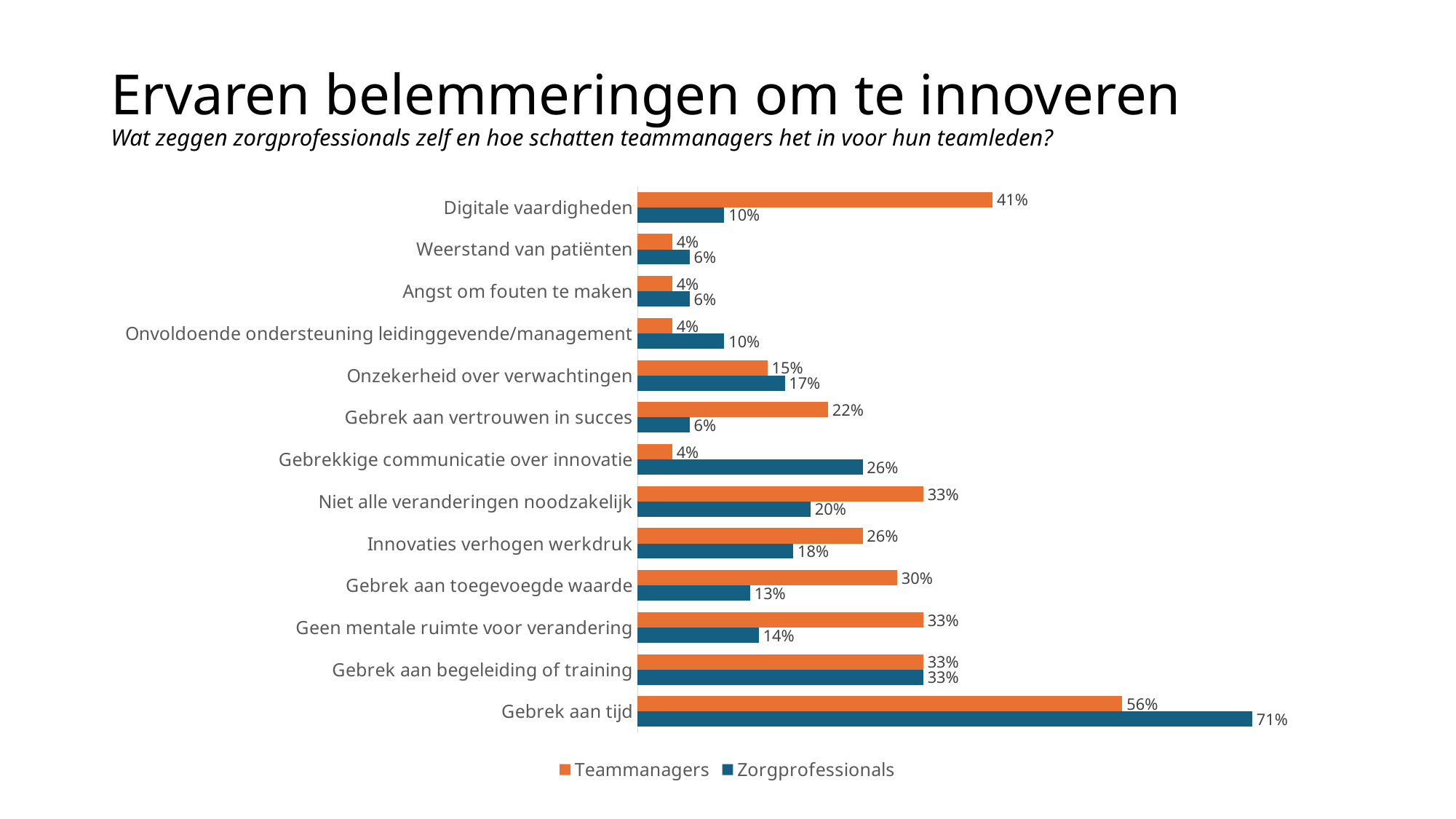
What is the Zorgprofessionals value for Gebrek aan tijd? 71% What is the difference between the Zorgprofessionals and Teammanagers values for Gebrek aan tijd? 15 percentage points What is the difference between the Teammanagers and Zorgprofessionals values for Digitale vaardigheden? 31 percentage points Which category has the highest Zorgprofessionals value? Gebrek aan tijd What is the Teammanagers value for Digitale vaardigheden? 41% How many series does the legend list? 2 For Gebrekkige communicatie over innovatie, which series has the larger value, Teammanagers or Zorgprofessionals? Zorgprofessionals How many categories are shown on the chart? 13 What is the Zorgprofessionals value for Gebrekkige communicatie over innovatie? 26% For Gebrek aan toegevoegde waarde, which series has the larger value, Teammanagers or Zorgprofessionals? Teammanagers Which category has the lowest Zorgprofessionals value? Weerstand van patiënten, Angst om fouten te maken, Gebrek aan vertrouwen in succes (all 6%) What kind of chart is shown on the slide? Bar chart